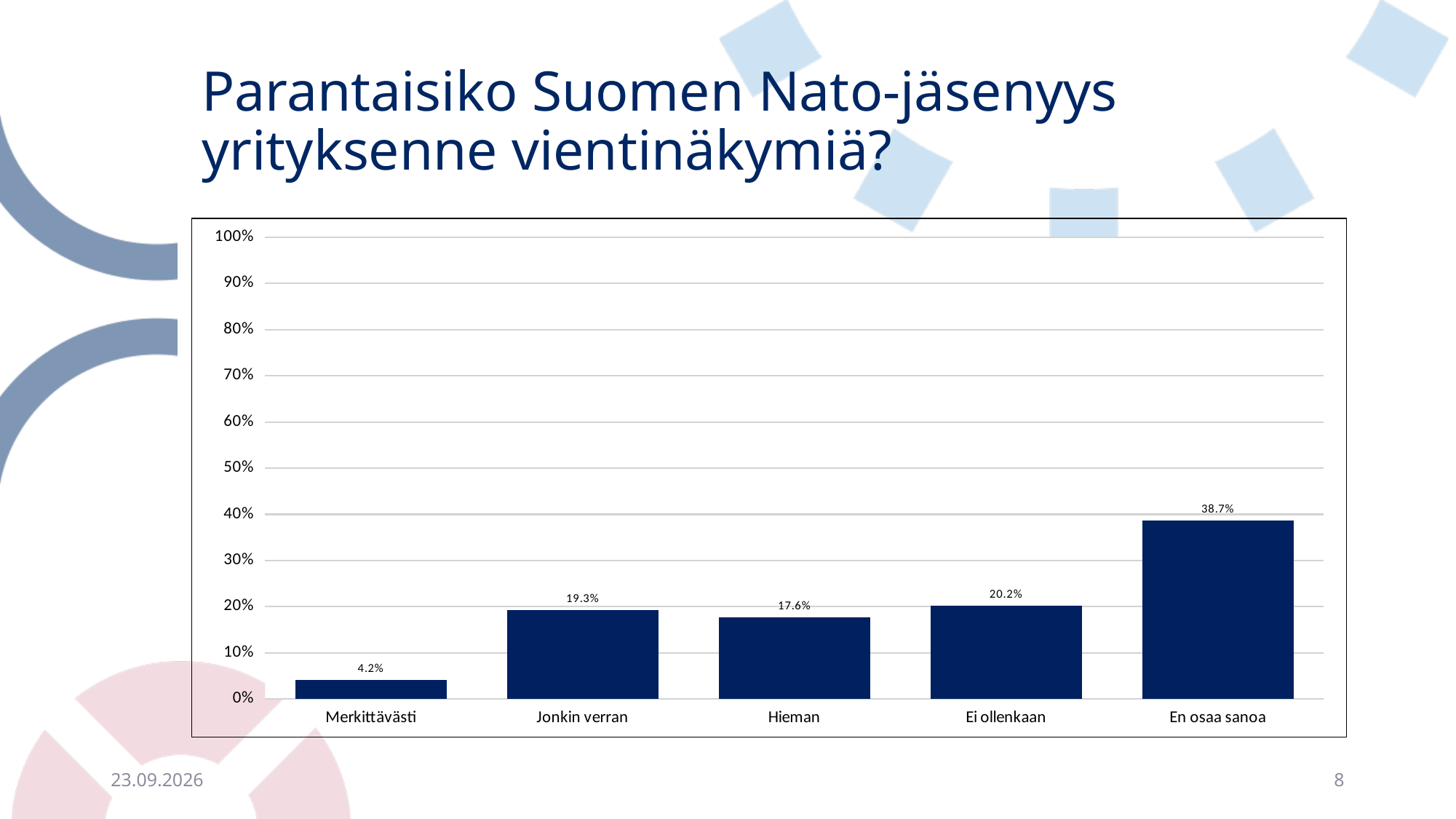
Is the value for En osaa sanoa greater or less than 30%? greater What is the value for Merkittävästi? 4.2% What is the difference between the values for En osaa sanoa and Ei ollenkaan? 18.5% How many categories are shown on the x axis? 5 Which category has the lowest value? Merkittävästi Which category has the highest value? En osaa sanoa What is the value for Hieman? 17.6% What is the value for Ei ollenkaan? 20.2% What is the value for Jonkin verran? 19.3% What is the value for En osaa sanoa? 38.7% What kind of chart is shown on the slide? Bar chart Which is larger, the value for Jonkin verran or the value for Hieman? Jonkin verran